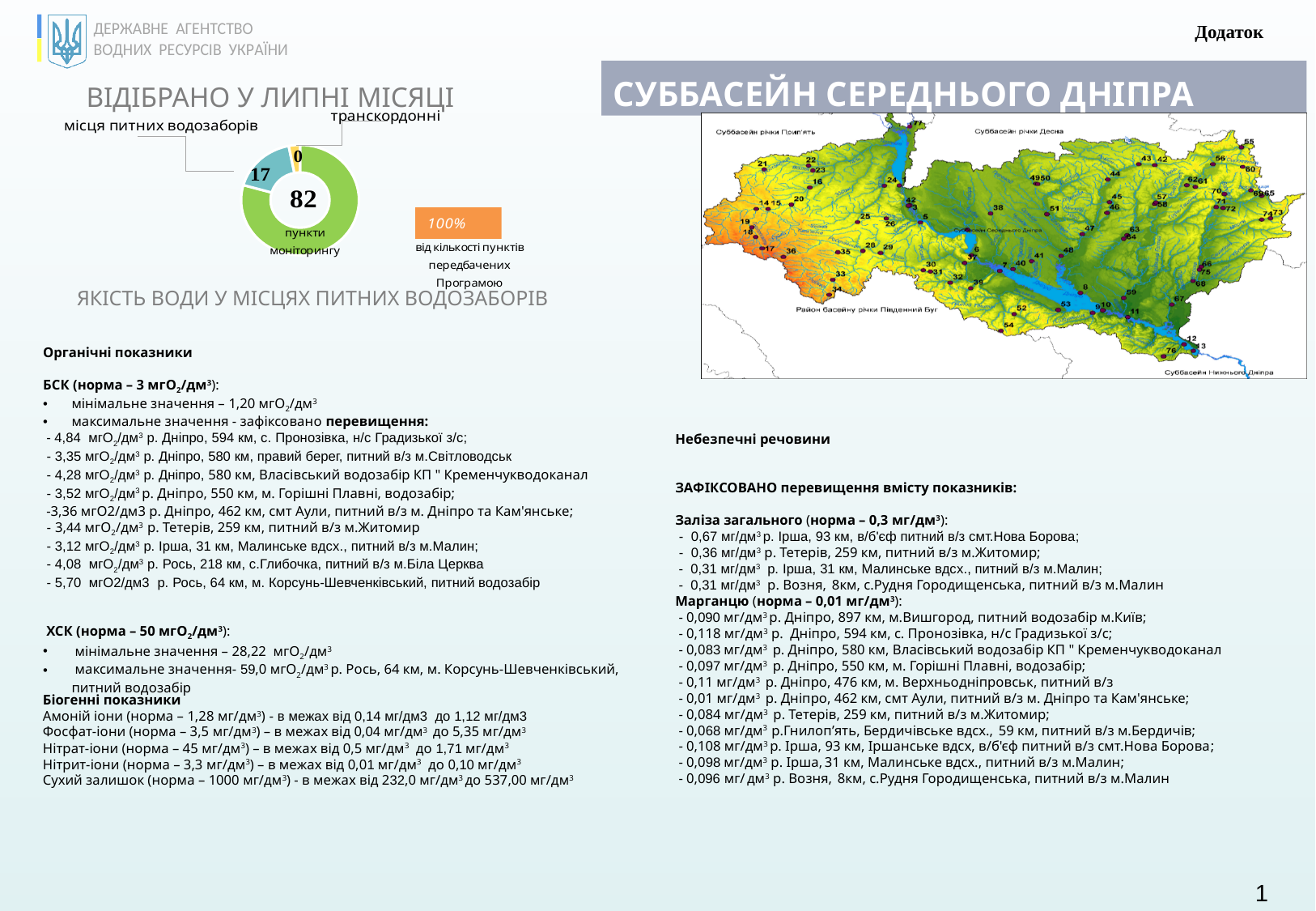
In the doughnut chart, which labelled category has the lowest value? транскордонні What number is printed in the centre of the doughnut chart? 82 What label accompanies the number 82 in the centre of the doughnut chart? пункти моніторингу In the doughnut chart, what value is shown for "місця питних водозаборів"? 17 Is the value for "місця питних водозаборів" in the doughnut chart greater or less than 10? greater What is the difference between the values for "місця питних водозаборів" and "транскордонні" in the doughnut chart? 17 What kind of chart is shown under the heading "ВІДІБРАНО У ЛИПНІ МІСЯЦІ"? Doughnut (pie) chart In the doughnut chart, what value is shown for "транскордонні"? 0 In the doughnut chart, which has the larger value: "місця питних водозаборів" or "транскордонні"? місця питних водозаборів What is the title above the doughnut chart? ВІДІБРАНО У ЛИПНІ МІСЯЦІ